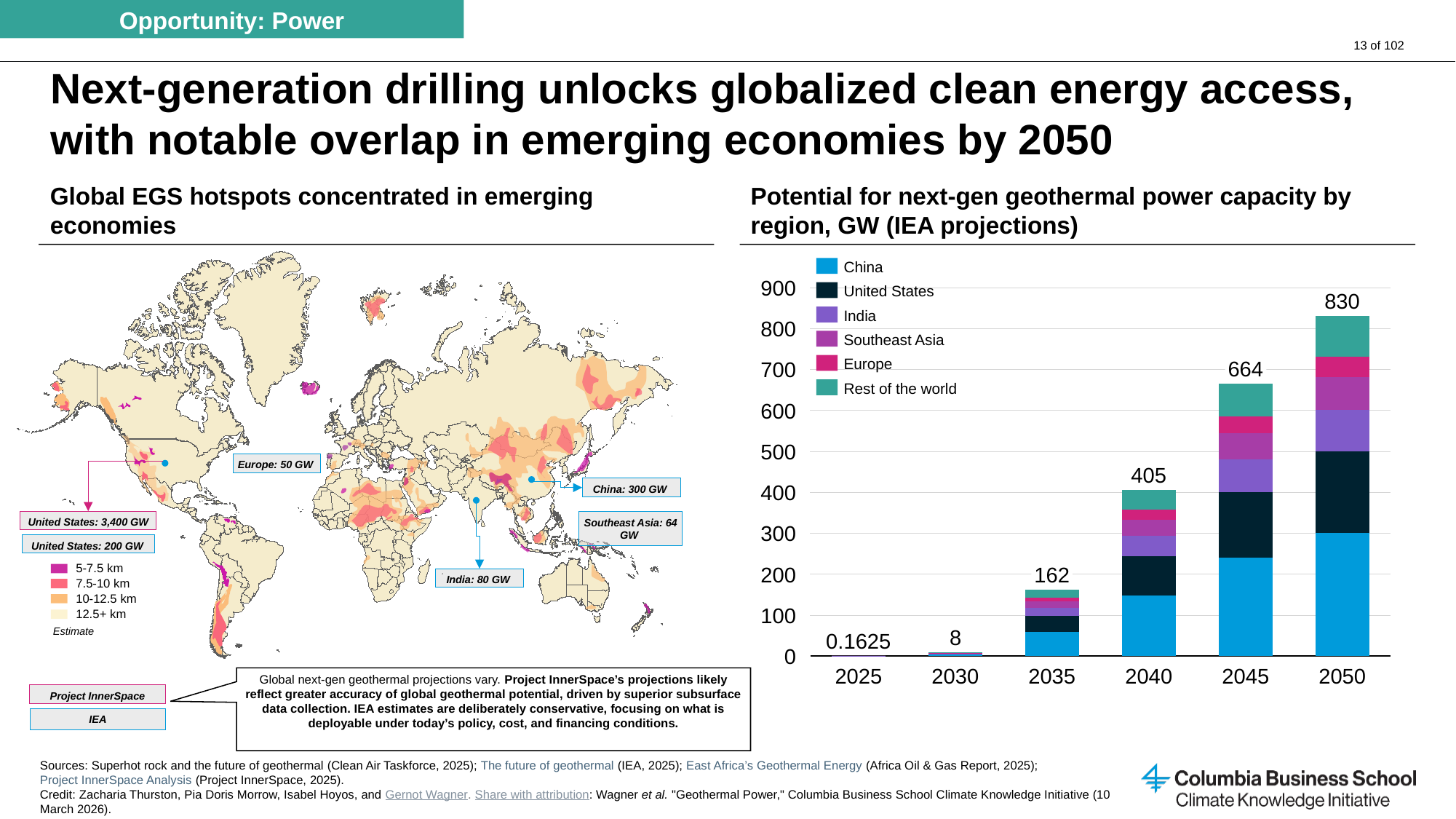
In the chart 'Potential for next-gen geothermal power capacity by region', how many years are shown on the x axis? 6 In the chart 'Potential for next-gen geothermal power capacity by region', which year has the highest total capacity? 2050 In the chart 'Potential for next-gen geothermal power capacity by region', what is the total capacity shown for 2040? 405 In the chart 'Potential for next-gen geothermal power capacity by region', how many regions does the legend list? 6 In the chart 'Potential for next-gen geothermal power capacity by region', do the total values rise or fall from 2025 to 2050? Rise In the chart 'Potential for next-gen geothermal power capacity by region', what is the total capacity shown for 2050? 830 In the chart 'Potential for next-gen geothermal power capacity by region', which year has the lowest total capacity? 2025 In the chart 'Potential for next-gen geothermal power capacity by region', is the China segment for 2040 greater or less than 100? greater In the chart 'Potential for next-gen geothermal power capacity by region', what value is labelled for 2025? 0.1625 What kind of chart is 'Potential for next-gen geothermal power capacity by region'? Stacked bar chart In the chart 'Potential for next-gen geothermal power capacity by region', what is the difference between the 2050 total and the 2045 total? 166 In the chart 'Potential for next-gen geothermal power capacity by region', which is larger, the total for 2045 or the total for 2040? 2045